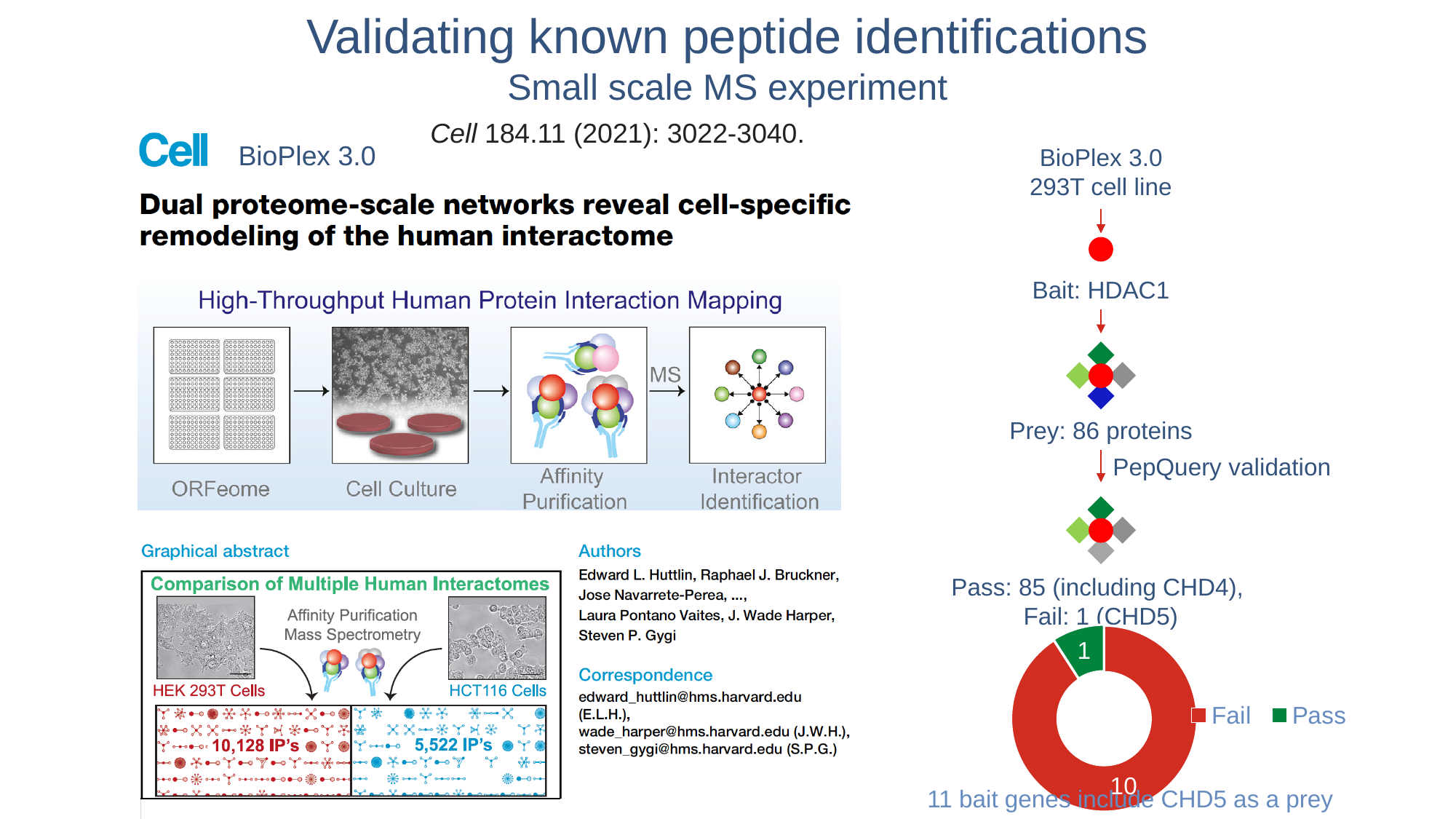
In the doughnut chart, what is the difference between the Fail and Pass values? 9 In the doughnut chart, what is the value for Pass? 1 In the doughnut chart, is the value for Fail larger or smaller than the value for Pass? Larger In the doughnut chart, which category has the smallest value? Pass How many categories does the doughnut chart's legend list? 2 How many slices does the doughnut chart have? 2 What kind of chart is shown at the bottom right of the slide? Doughnut chart What colour represents Pass in the doughnut chart? Green In the doughnut chart, what is the value for Fail? 10 What colour represents Fail in the doughnut chart? Red What is the total of the two values shown in the doughnut chart? 11 In the doughnut chart, which category has the larger value? Fail